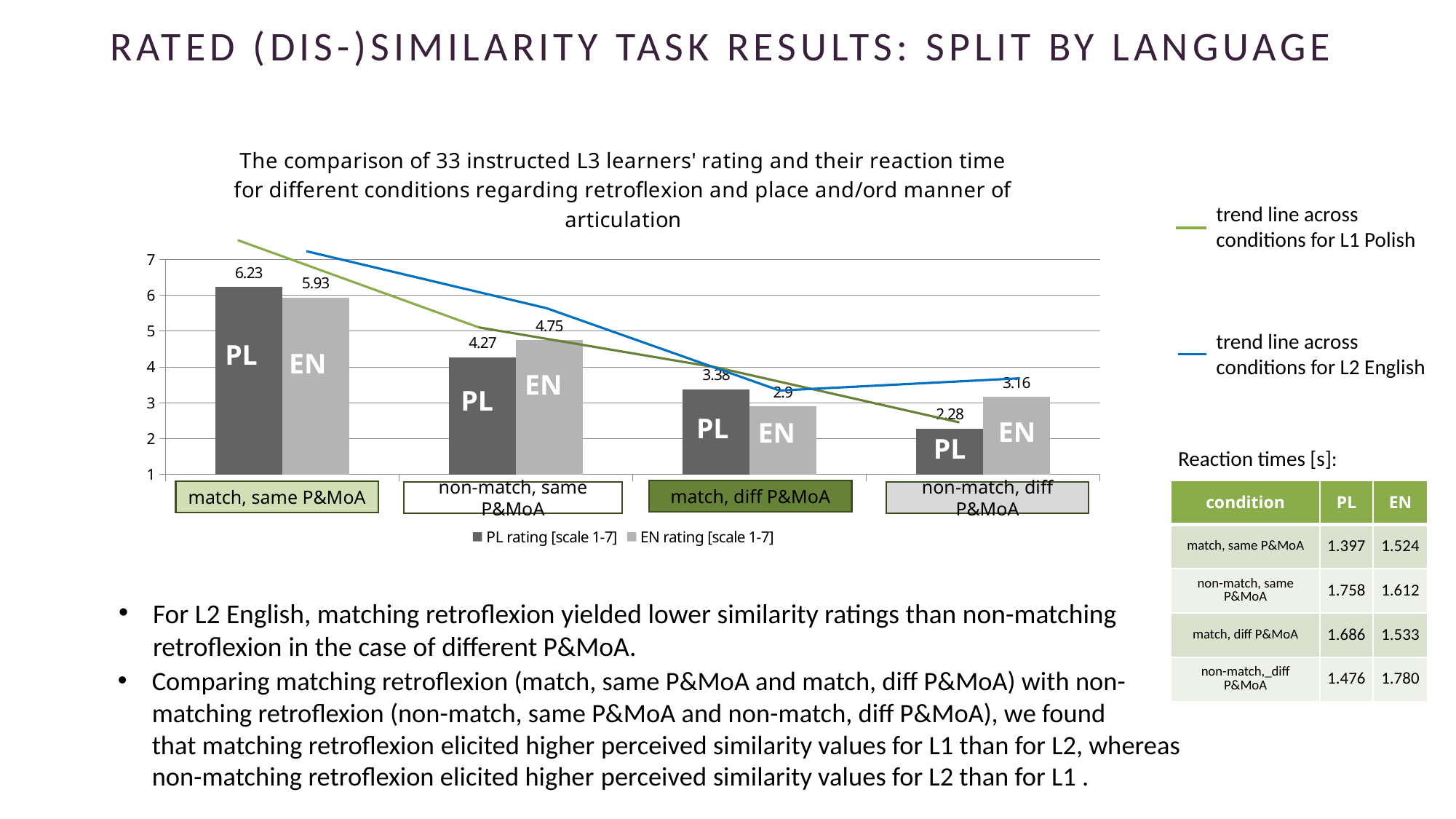
For the "non-match, diff P&MoA" condition, which is larger, the PL rating or the EN rating? EN rating How many conditions are shown on the x axis of the chart? 4 Which condition has the lowest EN rating? match, diff P&MoA What is the EN rating for the "match, diff P&MoA" condition? 2.9 Is the PL rating for "match, diff P&MoA" greater or less than 4? less Which condition has the highest PL rating? match, same P&MoA What is the EN rating for the "non-match, same P&MoA" condition? 4.75 How many series does the bar chart legend list? 2 What is the PL rating for the "match, same P&MoA" condition? 6.23 What is the difference between the PL rating and the EN rating for the "match, same P&MoA" condition? 0.3 Do the PL ratings rise or fall across the conditions from left to right? fall What is the PL rating for the "non-match, diff P&MoA" condition? 2.28